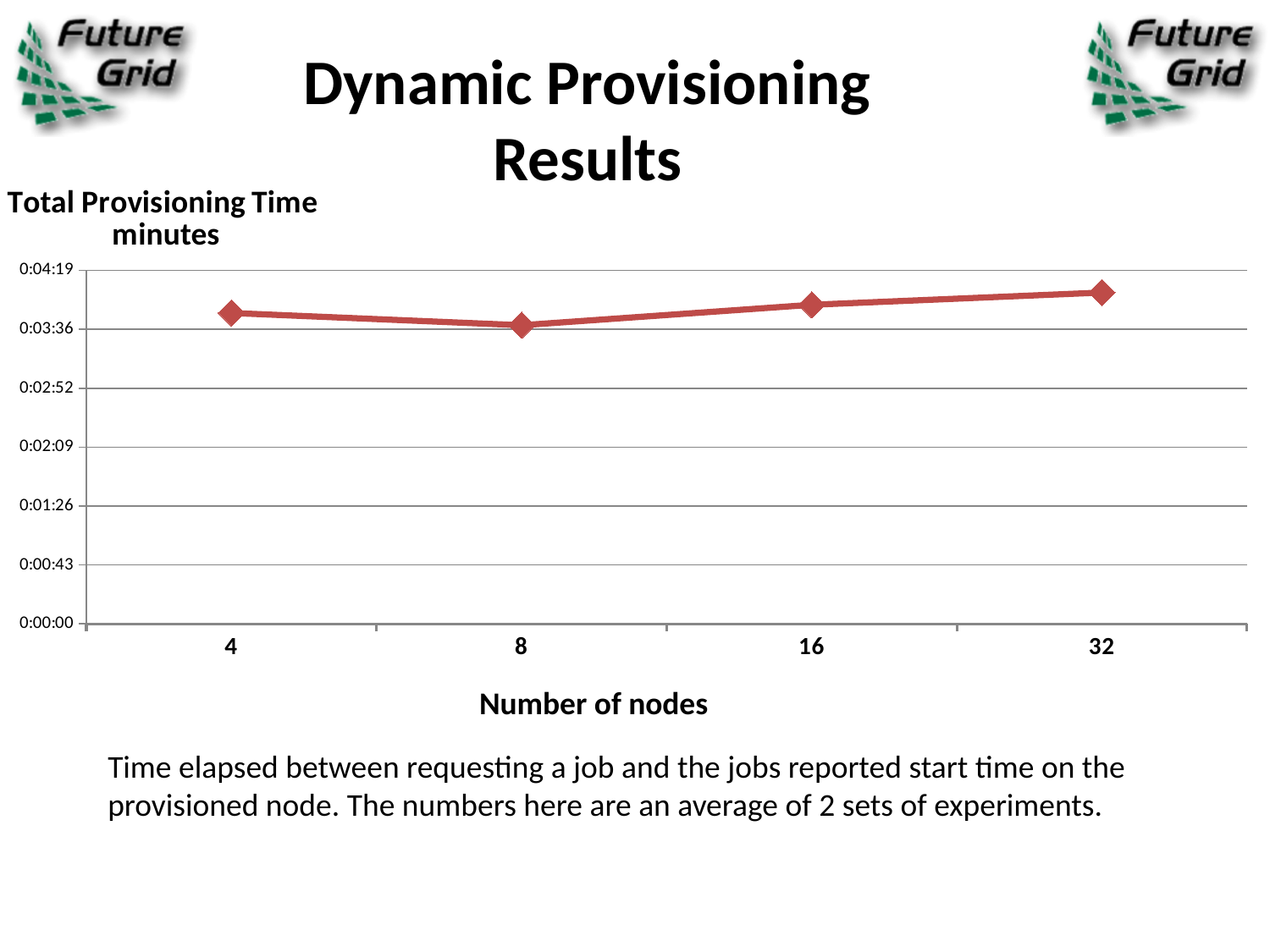
Which number of nodes has the highest total provisioning time? 32 Is the total provisioning time for 32 nodes greater or less than 0:04:19? less What is the label of the x axis? Number of nodes What is the title of the chart? Total Provisioning Time minutes Which number of nodes has the lowest total provisioning time? 8 What kind of chart is shown on the slide? line chart Which has the larger total provisioning time, 4 nodes or 8 nodes? 4 nodes Which has the larger total provisioning time, 16 nodes or 8 nodes? 16 nodes How many data points are plotted on the line? 4 From 8 nodes to 32 nodes, does the total provisioning time rise or fall? rise Is the total provisioning time for 4 nodes greater or less than 0:02:52? greater